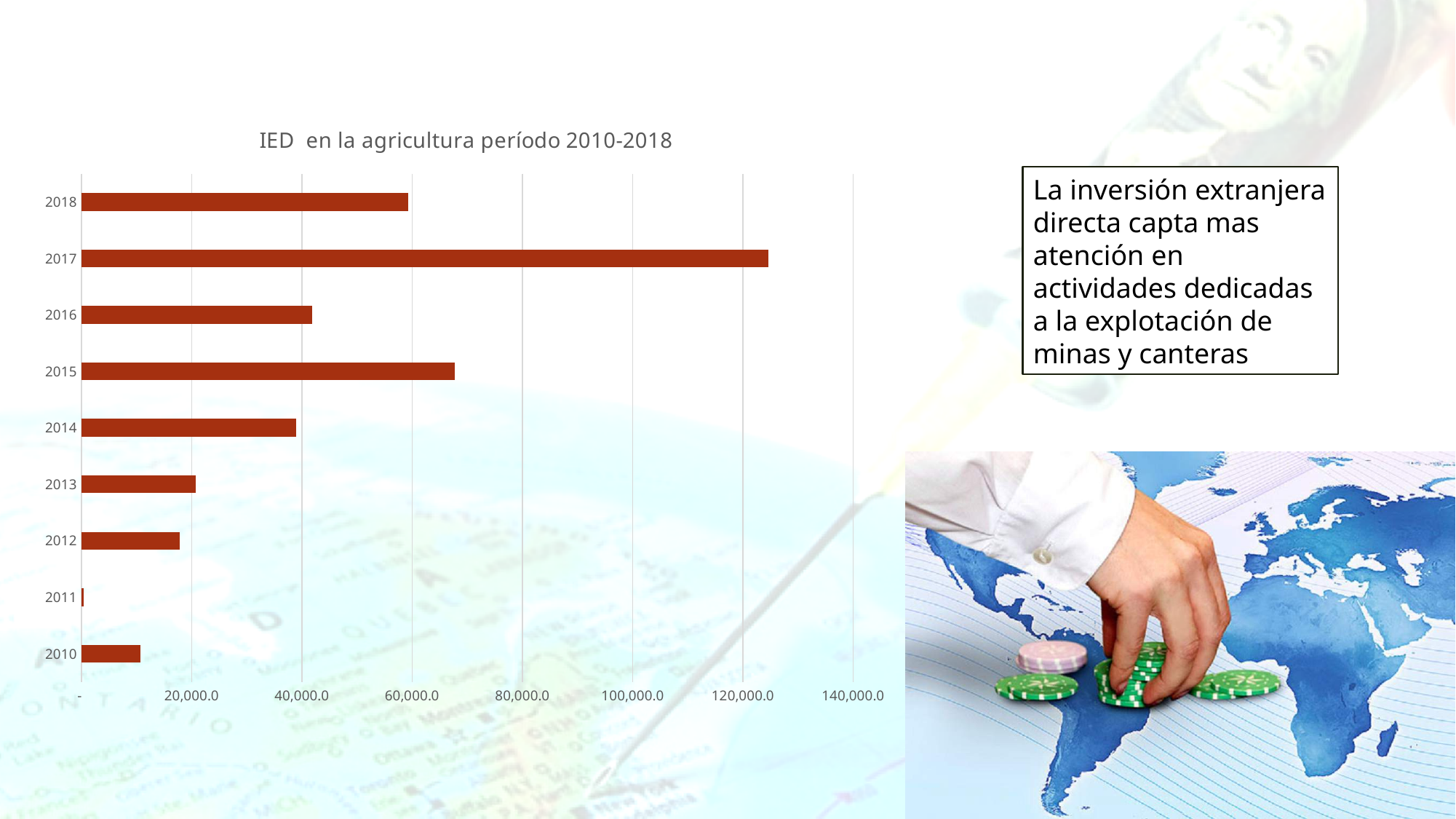
Is the value for 2016 greater or less than 60,000.0? less Which year has the larger value, 2015 or 2018? 2015 What kind of chart is shown on the slide? bar chart Which year has the larger value, 2017 or 2015? 2017 Is the value for 2010 greater or less than 20,000.0? less What is the title of the chart? IED en la agricultura período 2010-2018 Which year has the lowest value in the chart? 2011 Is the value for 2018 greater or less than 40,000.0? greater How many years are plotted in the chart? 9 Which year has the highest value in the chart? 2017